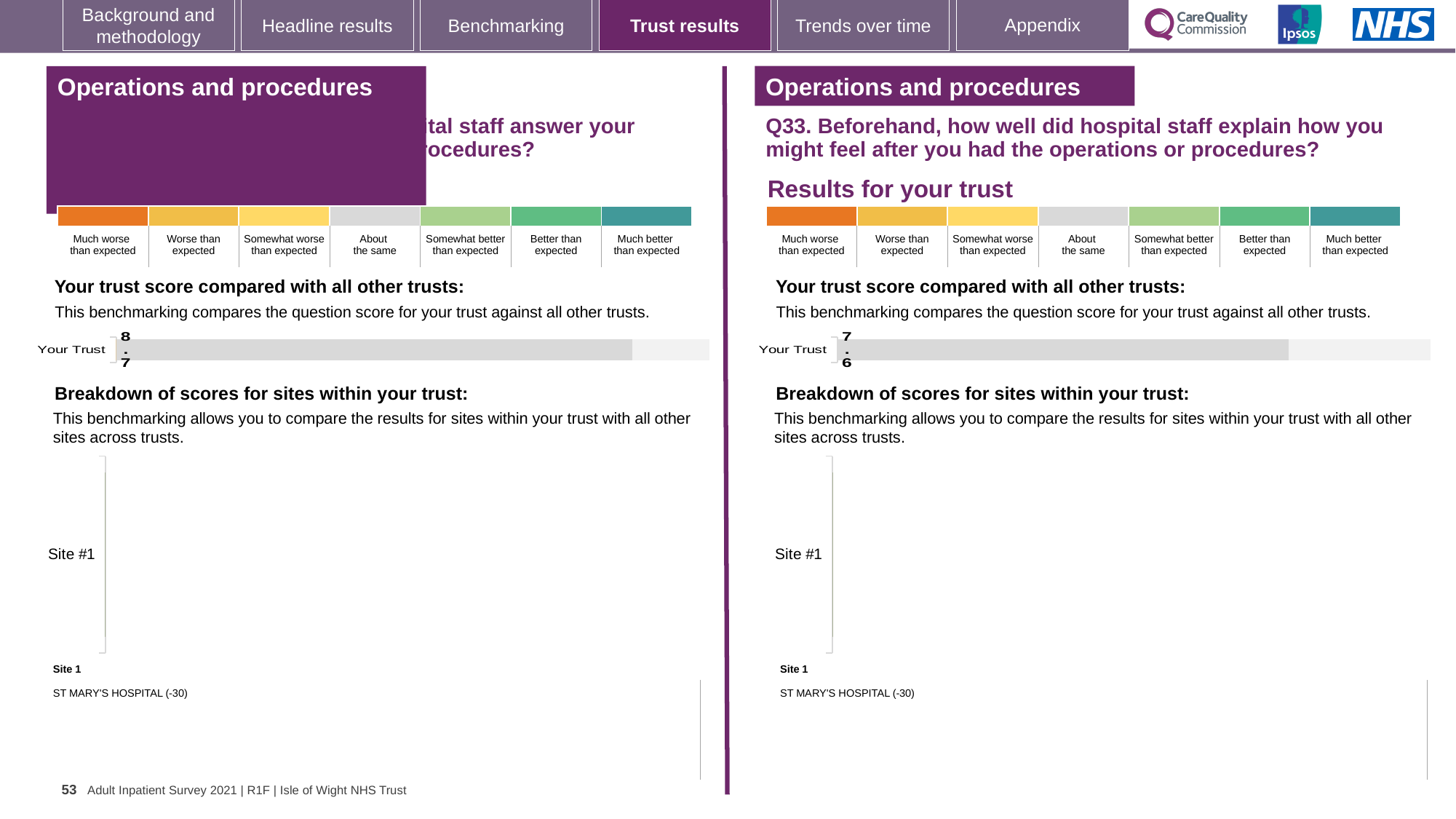
How many colour bands are shown in the rating scale above the right panel's Q33 chart, from 'Much worse than expected' to 'Much better than expected'? 7 How many bars are plotted in the left panel's 'Your trust score compared with all other trusts' chart? 1 Which Your Trust score is larger: the one on the left panel or the one on the right panel (Q33)? Left panel (8.7) What is the label of the single bar in the right panel's Q33 trust score chart? Your Trust What is the difference between the Your Trust score on the left panel (8.7) and the Your Trust score on the right panel (7.6)? 1.1 On the right panel's Q33 'Your trust score compared with all other trusts' chart, what is the value shown for Your Trust? 7.6 On the left panel's 'Your trust score compared with all other trusts' chart, what is the value shown for Your Trust? 8.7 What kind of chart is used to show the Your Trust score on the right panel (Q33)? Bar chart